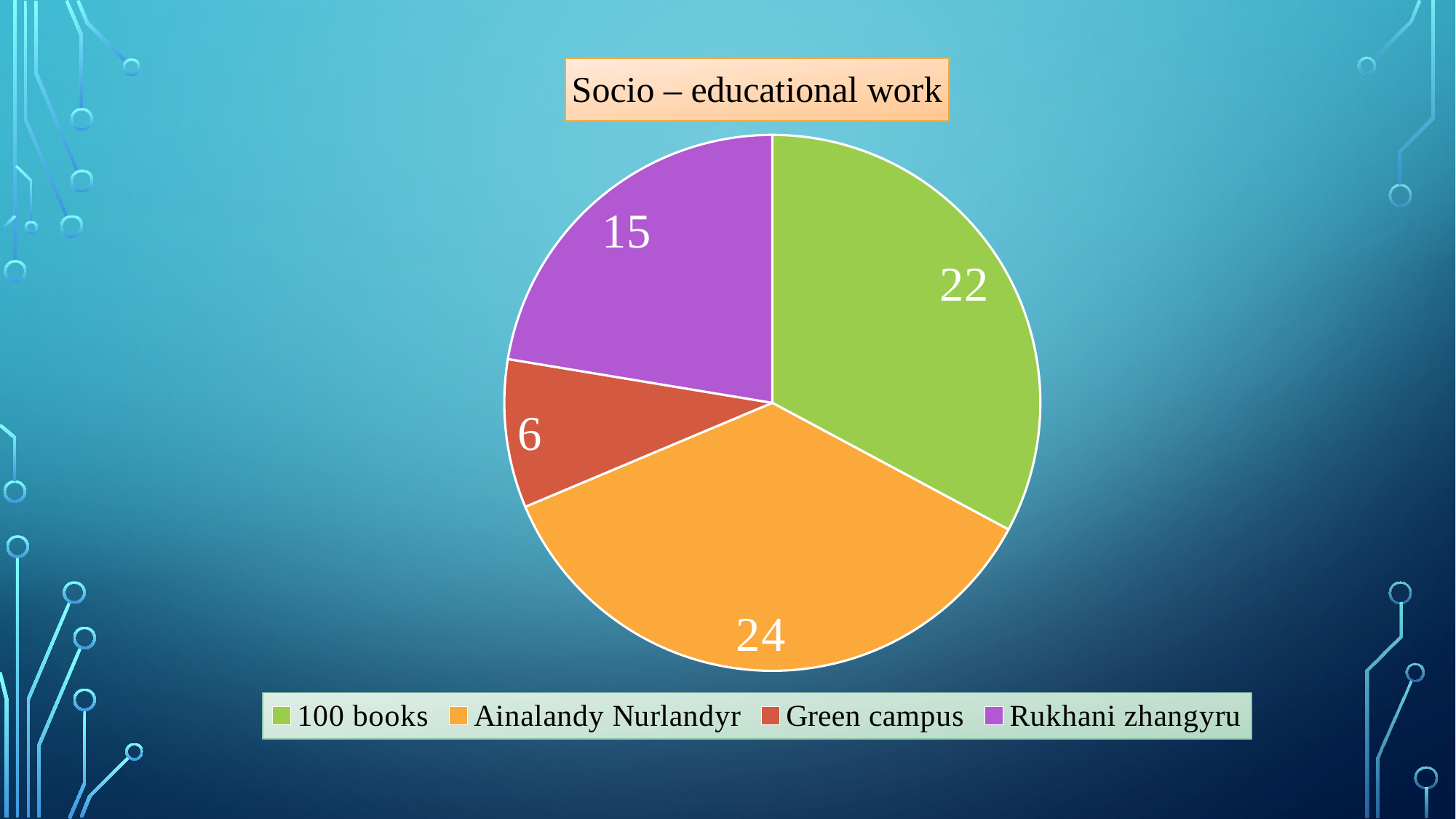
What type of chart is shown on the slide? Pie chart How many categories does the pie chart show? 4 What is the value of the Ainalandy Nurlandyr slice? 24 What is the value of the Green campus slice? 6 What is the title of the chart? Socio – educational work What is the difference between the Ainalandy Nurlandyr value and the Green campus value? 18 Which is larger, the 100 books slice or the Rukhani zhangyru slice? 100 books What is the value of the 100 books slice in the pie chart? 22 What is the total of all the slices in the pie chart? 67 Which category has the smallest slice in the pie chart? Green campus Which category has the largest slice in the pie chart? Ainalandy Nurlandyr What is the value of the Rukhani zhangyru slice? 15